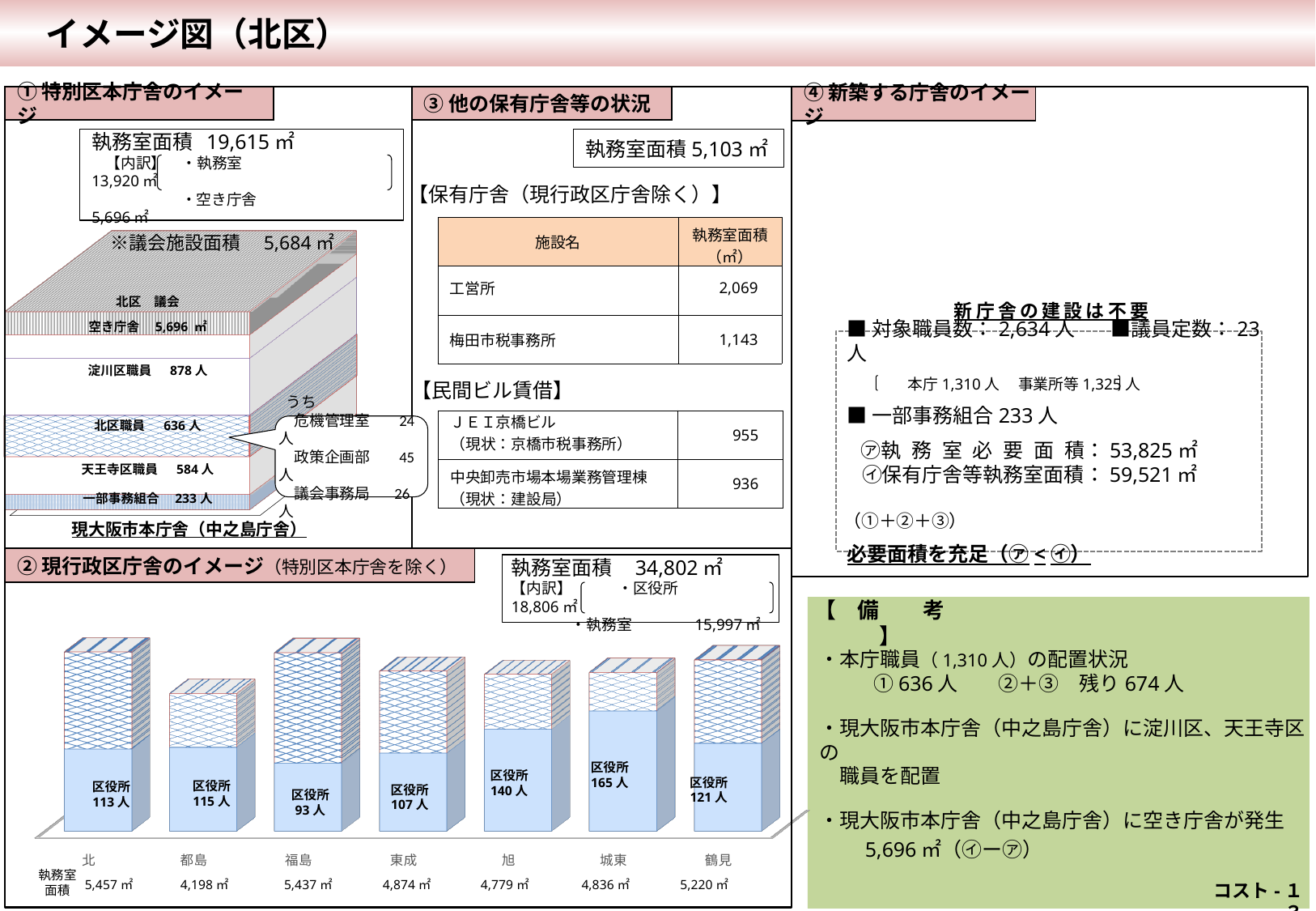
In the bar chart under ②現行政区庁舎のイメージ, which has more 区役所 staff, 北 or 都島? 都島 In the bar chart under ②現行政区庁舎のイメージ, which ward has the lowest number of 区役所 staff? 福島 What kind of chart is shown under ②現行政区庁舎のイメージ? bar chart In the bar chart under ②現行政区庁舎のイメージ, which ward has the smallest 執務室面積? 都島 In the bar chart under ②現行政区庁舎のイメージ, which ward has the largest 執務室面積? 北 In the bar chart under ②現行政区庁舎のイメージ, which ward has the highest number of 区役所 staff? 城東 In the bar chart under ②現行政区庁舎のイメージ, how many 区役所 staff are shown for 旭? 140 人 In the bar chart under ②現行政区庁舎のイメージ, how many wards are shown? 7 In the stacked diagram under ①特別区本庁舎のイメージ, how many 淀川区職員 are shown? 878 人 In the bar chart under ②現行政区庁舎のイメージ, what is the difference in 区役所 staff between 城東 and 福島? 72 人 In the bar chart under ②現行政区庁舎のイメージ, what is the difference in 執務室面積 between 北 and 都島? 1,259 ㎡ In the bar chart under ②現行政区庁舎のイメージ, what is the 執務室面積 shown for 鶴見? 5,220 ㎡